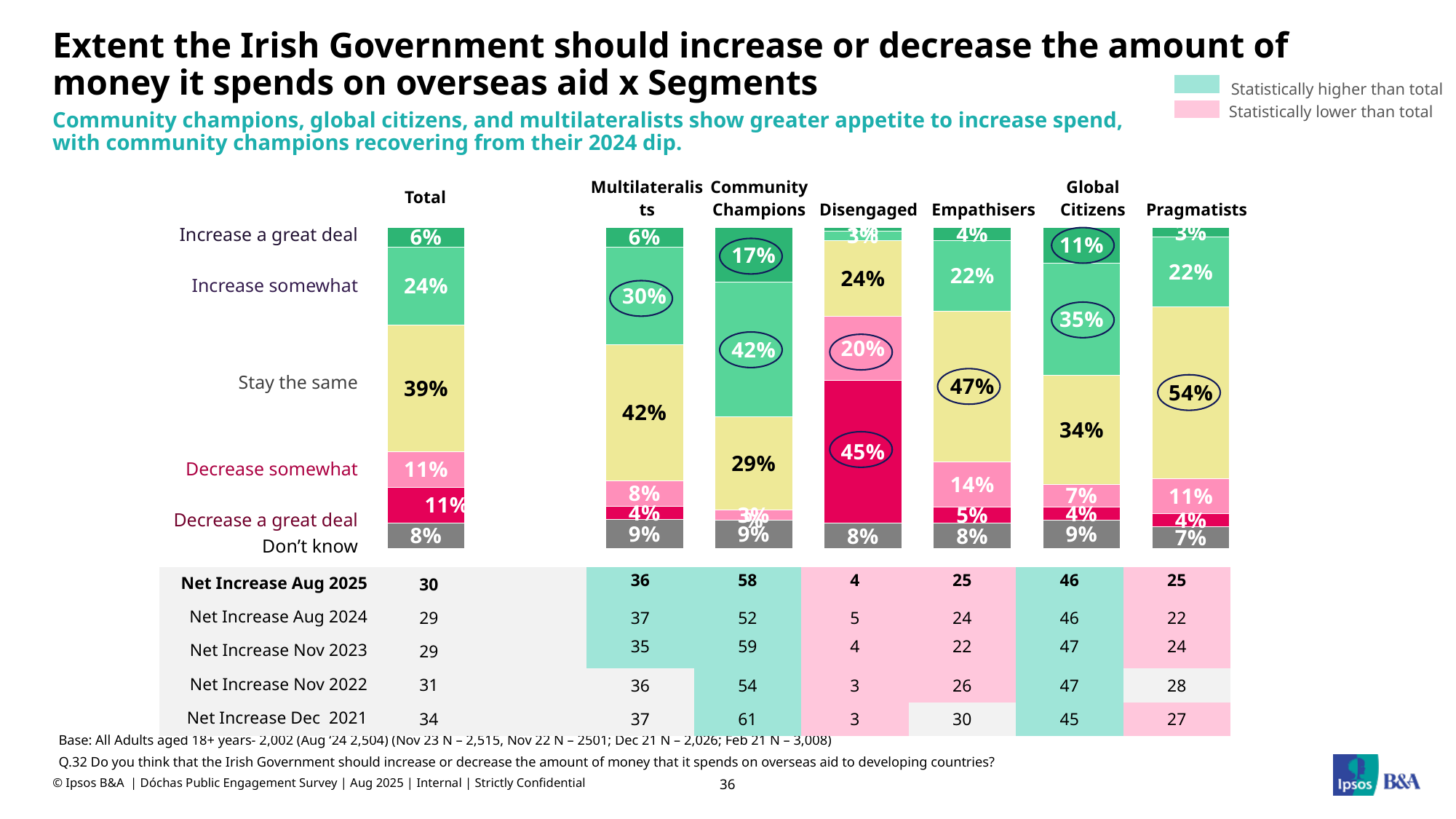
Which segment has the lowest Net Increase score for Aug 2025? Disengaged How many response categories make up each stacked bar? 6 What percentage of Community Champions say the government should increase overseas aid spending a great deal? 17% What is the Net Increase Aug 2025 value for Community Champions? 58 Which is larger: the 'Decrease somewhat' percentage for Empathisers or for Global Citizens? Empathisers How many bars (Total plus segments) are shown in the chart? 7 What percentage of Global Citizens say overseas aid spending should stay the same? 34% What is the difference between the 'Increase somewhat' percentages for Multilateralists and Empathisers? 8% Which segment has the highest 'Stay the same' percentage? Pragmatists What percentage of the Disengaged segment say the government should decrease overseas aid spending a great deal? 45% What percentage of the Total say the government should increase overseas aid spending somewhat? 24% What type of chart is used to show the responses by segment? Stacked bar chart